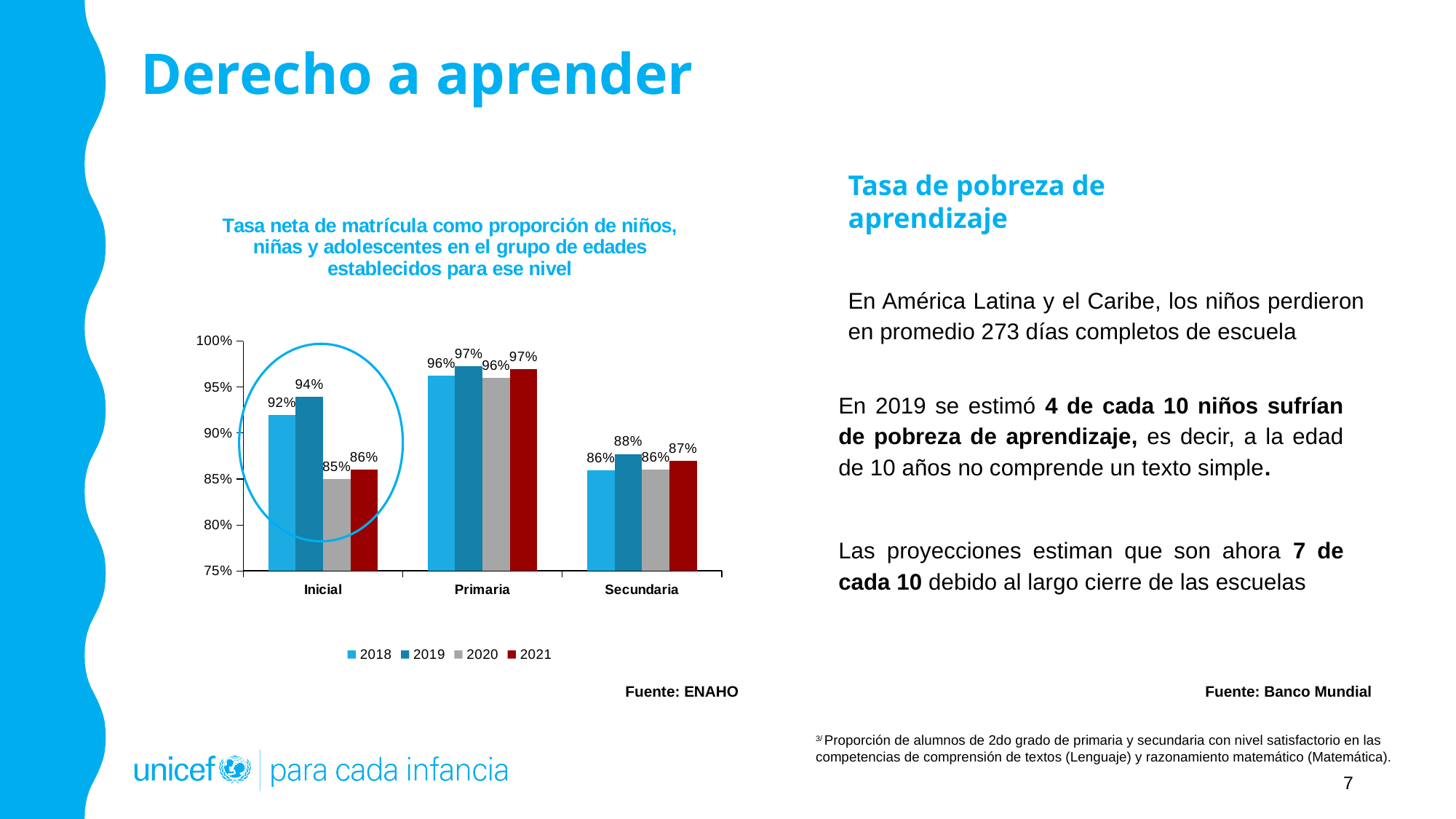
What is the value for Primaria in 2021? 97% Which year has the lowest value for Inicial? 2020 What is the value for Secundaria in 2019? 88% How many series does the legend list? 4 Which is larger: the Inicial value in 2018 or the Secundaria value in 2018? Inicial (92%) What is the net enrolment rate for Inicial in 2020? 85% Which category has the highest value in 2018? Primaria How many categories are shown on the x axis? 3 Which category on the chart is circled? Inicial What kind of chart is shown on the slide? Bar chart What is the difference between the Inicial values for 2019 and 2020? 9 percentage points Did the Inicial enrolment rate rise or fall from 2019 to 2020? Fall